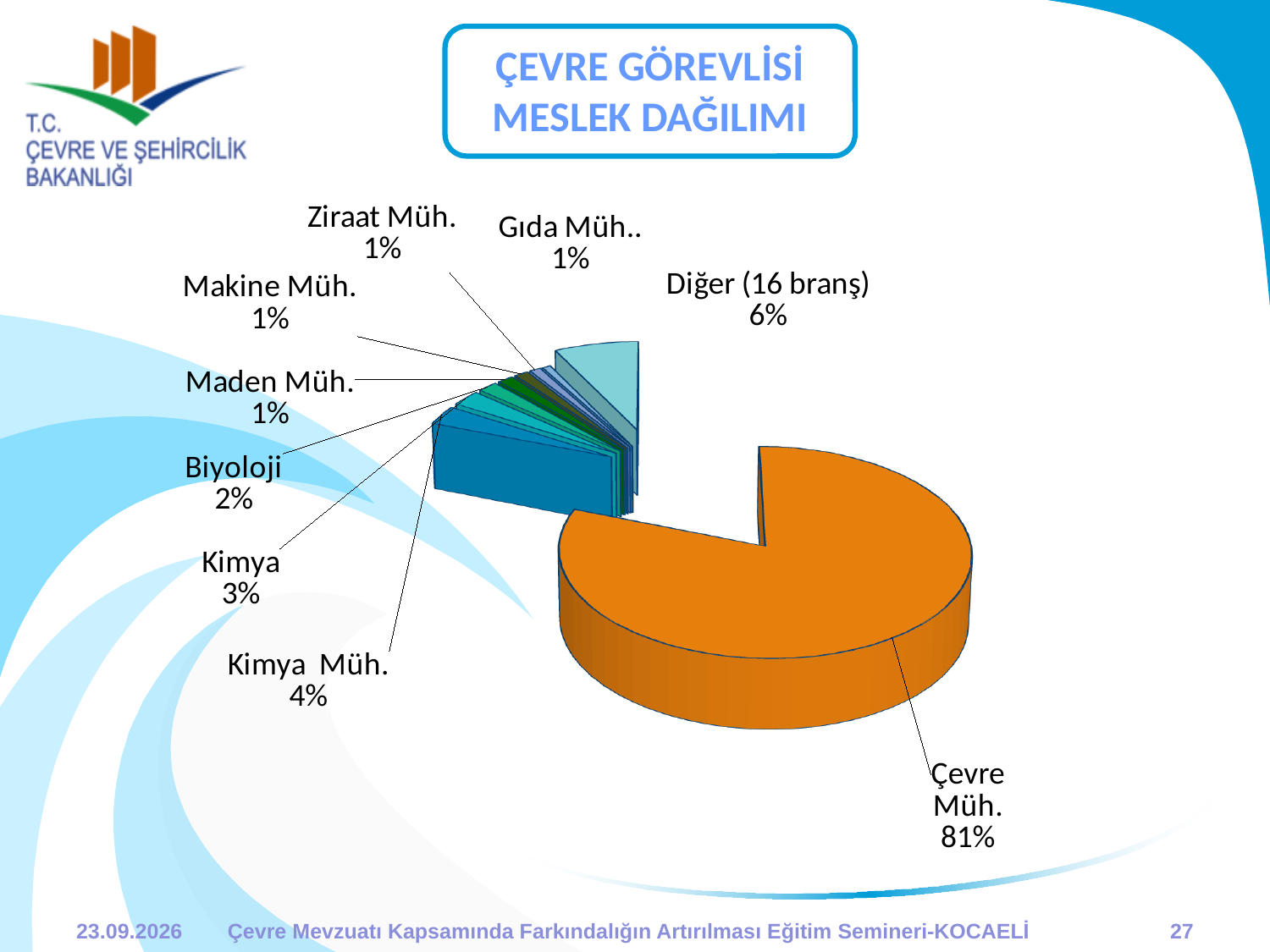
What percentage is shown for Diğer (16 branş)? 6% What colour is the Çevre Müh. slice? orange What percentage is shown for Biyoloji? 2% What is the title of the chart? ÇEVRE GÖREVLİSİ MESLEK DAĞILIMI What share of the pie does Çevre Müh. have? 81% What percentage is shown for Kimya Müh.? 4% How many slices does the pie chart have? 9 Which category has the largest slice of the pie? Çevre Müh. What is the difference in percentage points between Kimya Müh. and Kimya? 1 Which is larger, the share for Kimya or the share for Biyoloji? Kimya What kind of chart is shown on the slide? pie chart What is the difference in percentage points between Çevre Müh. and Diğer (16 branş)? 75